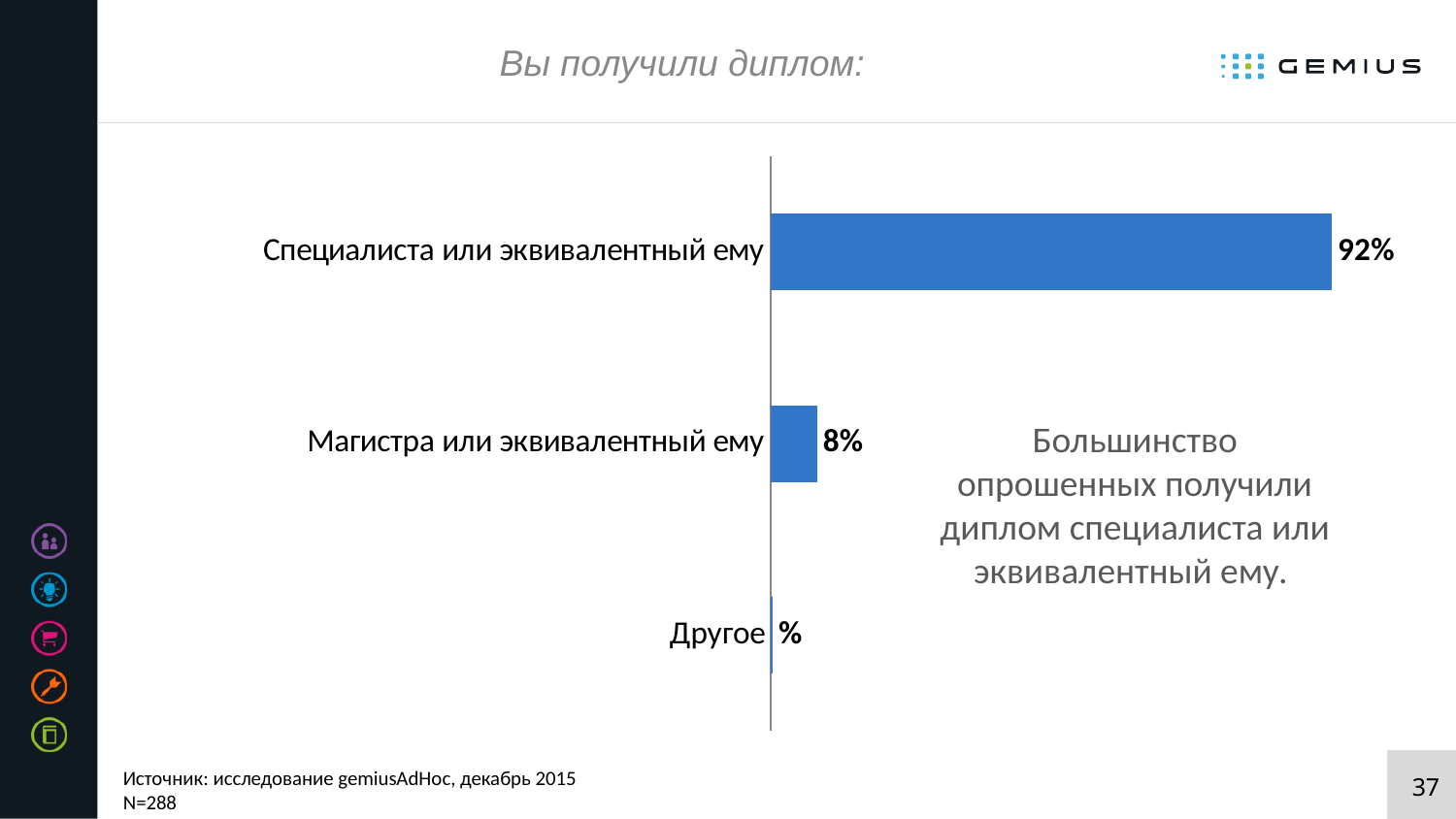
What type of chart is shown on the slide? Bar chart Which category has the highest value in the chart? Специалиста или эквивалентный ему What is the sample size (N) stated on the slide? N=288 What percentage of respondents received a Специалиста или эквивалентный ему diploma? 92% How many categories are shown in the chart? 3 Which is larger: the value for Специалиста или эквивалентный ему or for Магистра или эквивалентный ему? Специалиста или эквивалентный ему Which category has the lowest value in the chart? Другое What is the value shown for Магистра или эквивалентный ему? 8% What is the difference between the values for Специалиста или эквивалентный ему and Магистра или эквивалентный ему? 84% What is the title of the chart on the slide? Вы получили диплом: